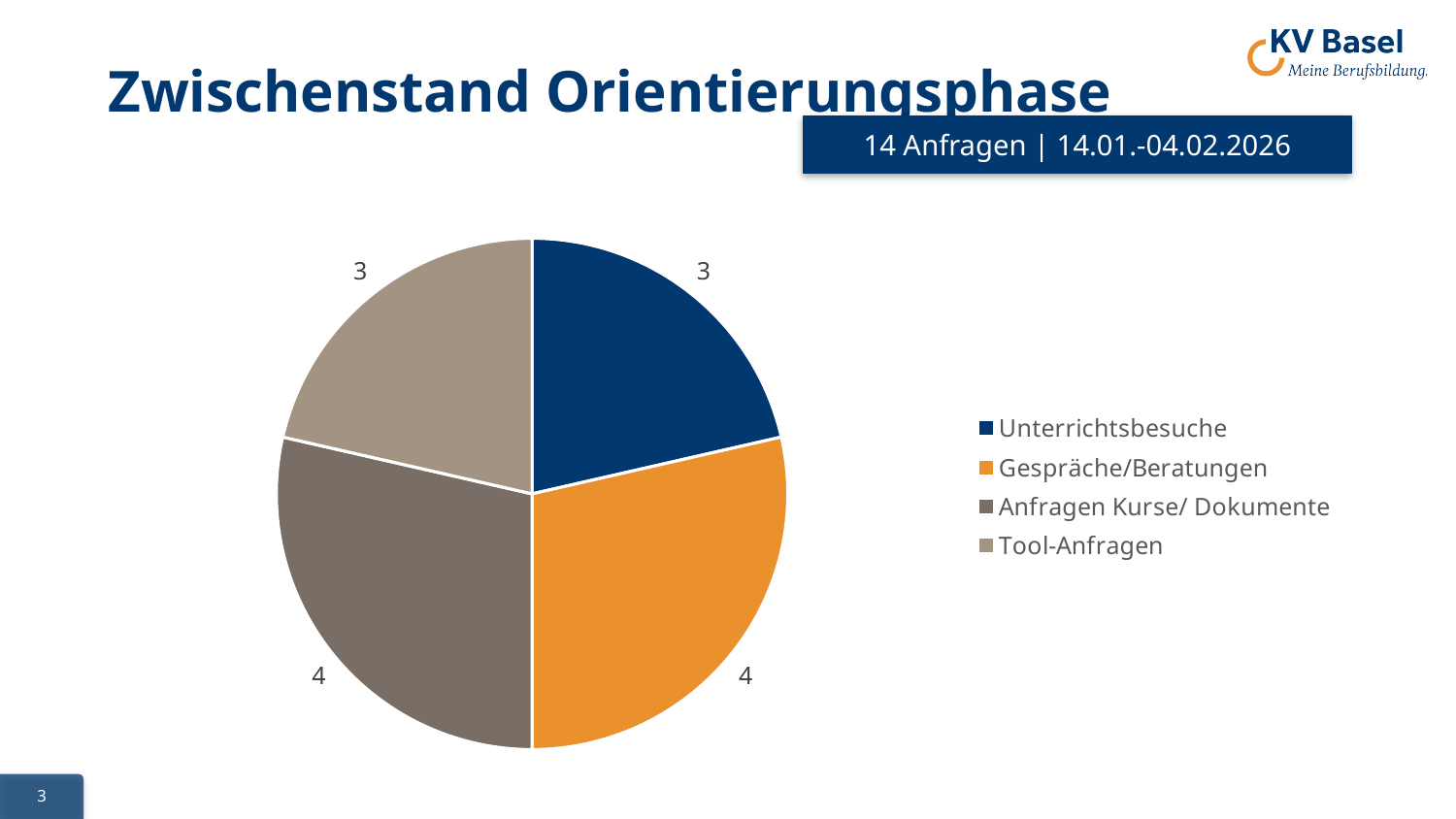
What is the value for Anfragen Kurse/ Dokumente in the pie chart? 4 What is the value for Unterrichtsbesuche in the pie chart? 3 Which is larger in the pie chart: Gespräche/Beratungen or Unterrichtsbesuche? Gespräche/Beratungen What kind of chart is shown on the slide? Pie chart What is the total of all slices in the pie chart? 14 How many slices does the pie chart have? 4 What is the difference between the values for Anfragen Kurse/ Dokumente and Tool-Anfragen? 1 What is the value for Tool-Anfragen in the pie chart? 3 What is the value for Gespräche/Beratungen in the pie chart? 4 Which is larger in the pie chart: Tool-Anfragen or Anfragen Kurse/ Dokumente? Anfragen Kurse/ Dokumente Which colour represents Gespräche/Beratungen in the pie chart? Orange How many entries does the legend of the pie chart list? 4